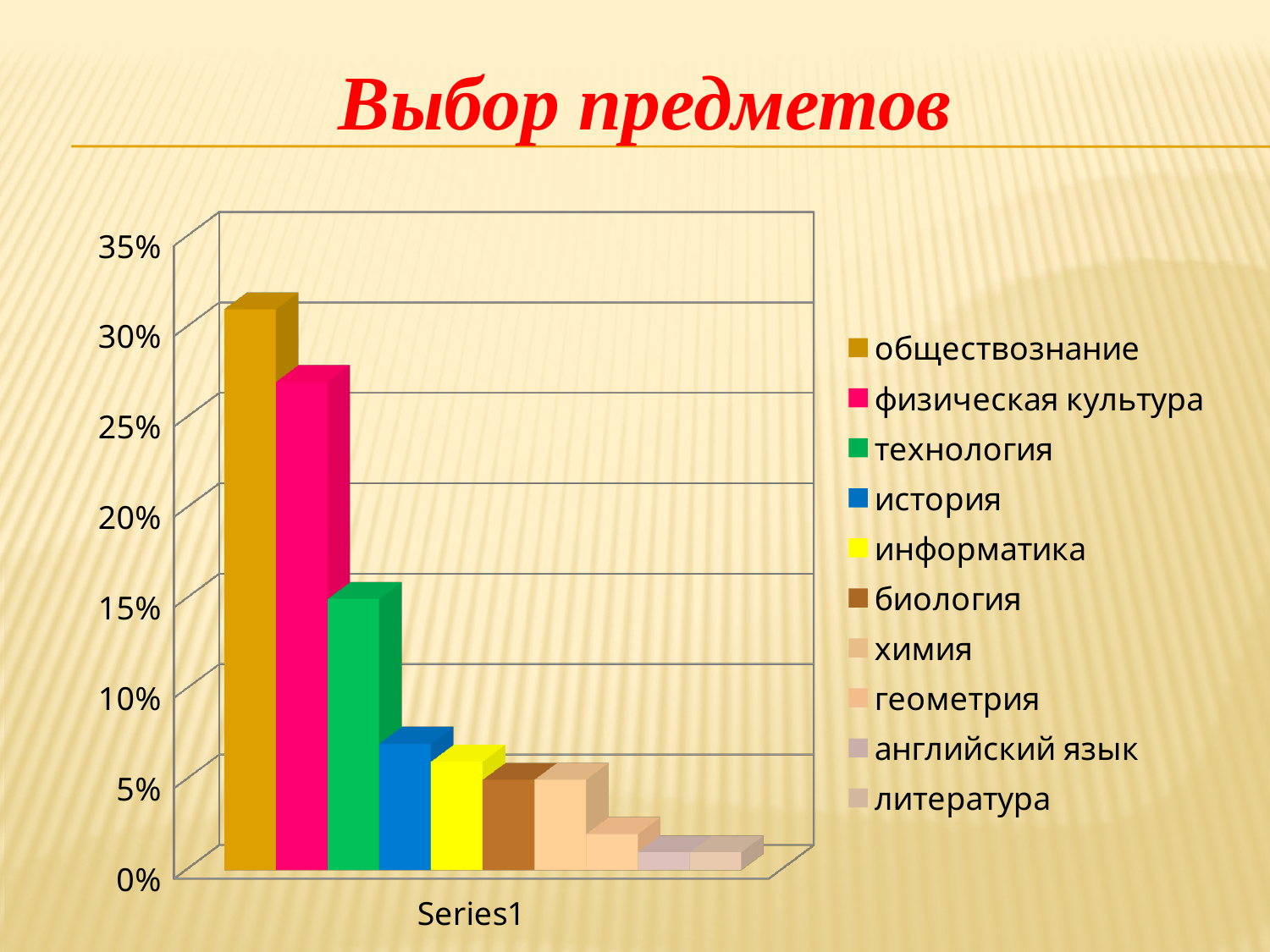
What is the title of the chart? Выбор предметов Which subject has the highest bar? обществознание Which is larger, the value for история or the value for физическая культура? физическая культура Is the value for технология greater or less than 10%? greater What kind of chart is shown on the slide? bar chart How many entries does the legend list? 10 Is the value for технология greater or less than 20%? less Is the value for обществознание greater or less than 25%? greater What colour is the bar for технология in the legend? green How many bars are plotted in the chart? 10 Which is larger, the value for обществознание or the value for технология? обществознание